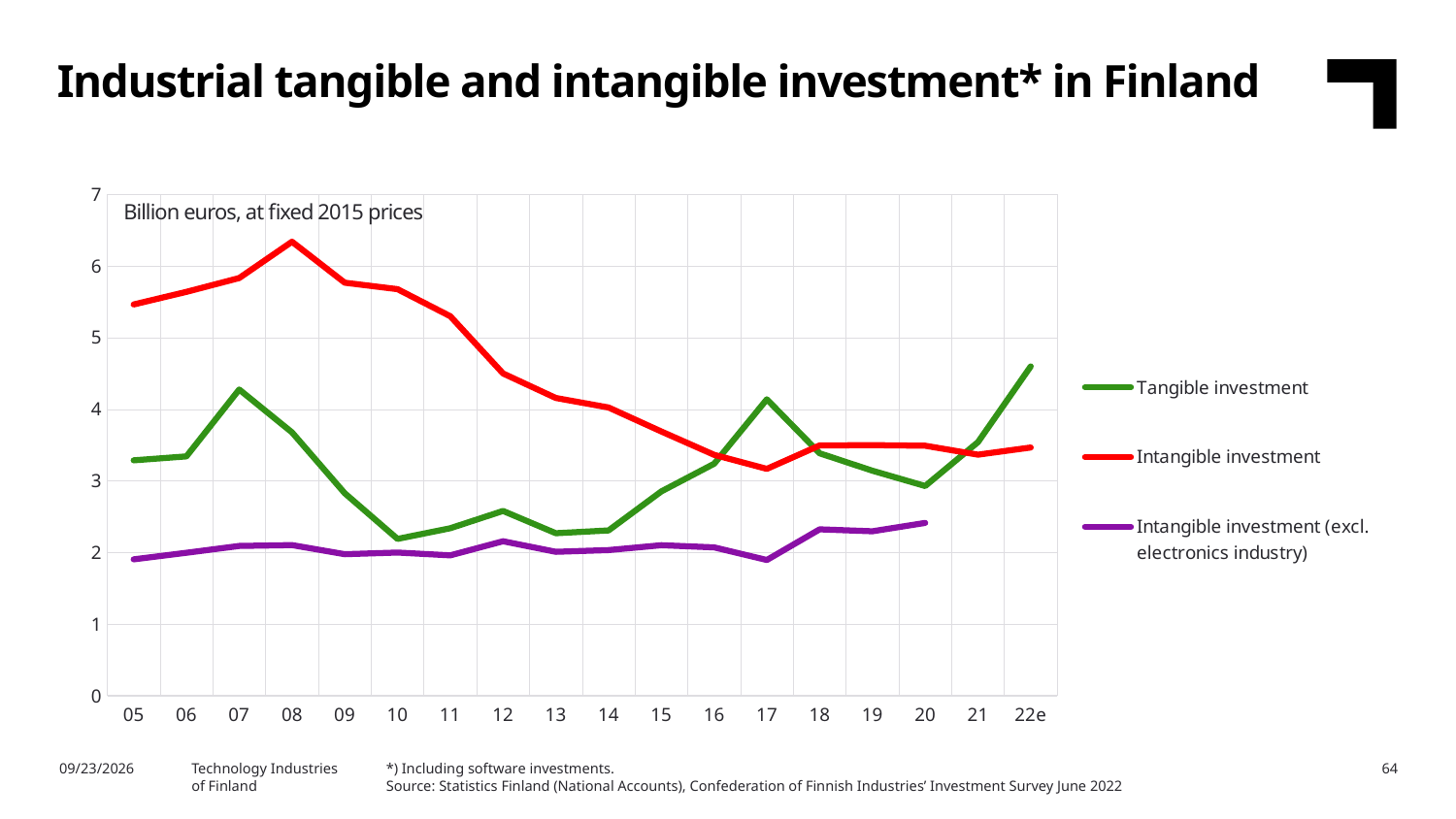
In which year does intangible investment reach its highest value? 08 Is the value for intangible investment in 08 greater or less than 6? greater In which year does tangible investment reach its highest value? 22e In which year is intangible investment at its lowest? 17 Is the value for intangible investment (excl. electronics industry) in 20 greater or less than 3? less What type of chart is shown on the slide? line chart Is the value for tangible investment in 10 greater or less than 3? less In 22e, which is larger: tangible investment or intangible investment? Tangible investment How many years are shown on the x axis? 18 In 05, which is larger: tangible investment or intangible investment? Intangible investment How many series does the legend list? 3 Does intangible investment rise or fall between 08 and 17? fall